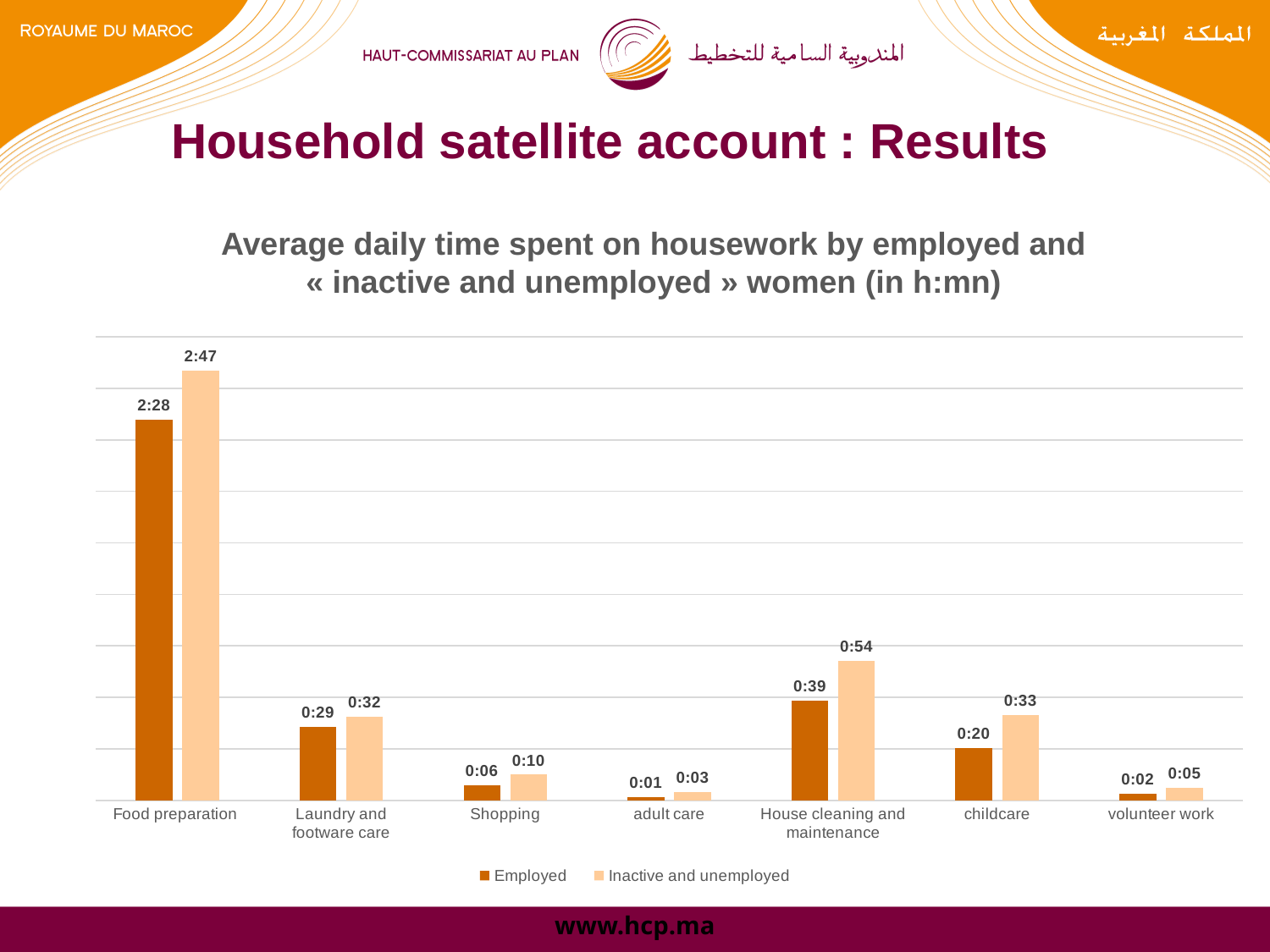
What is the value for volunteer work in the Inactive and unemployed series? 0:05 What is the difference between the two series for house cleaning and maintenance? 0:15 Which activity has the highest value for inactive and unemployed women? Food preparation What is the average daily time spent on food preparation by employed women? 2:28 What type of chart is shown on the slide? Bar chart How many activity categories are shown on the x axis? 7 For childcare, which series has the larger value, Employed or Inactive and unemployed? Inactive and unemployed Which activity has the lowest value for employed women? adult care How many series does the legend list? 2 What is the value for childcare in the Employed series? 0:20 What is the difference between the inactive and unemployed value and the employed value for food preparation? 0:19 What is the average daily time spent on house cleaning and maintenance by inactive and unemployed women? 0:54